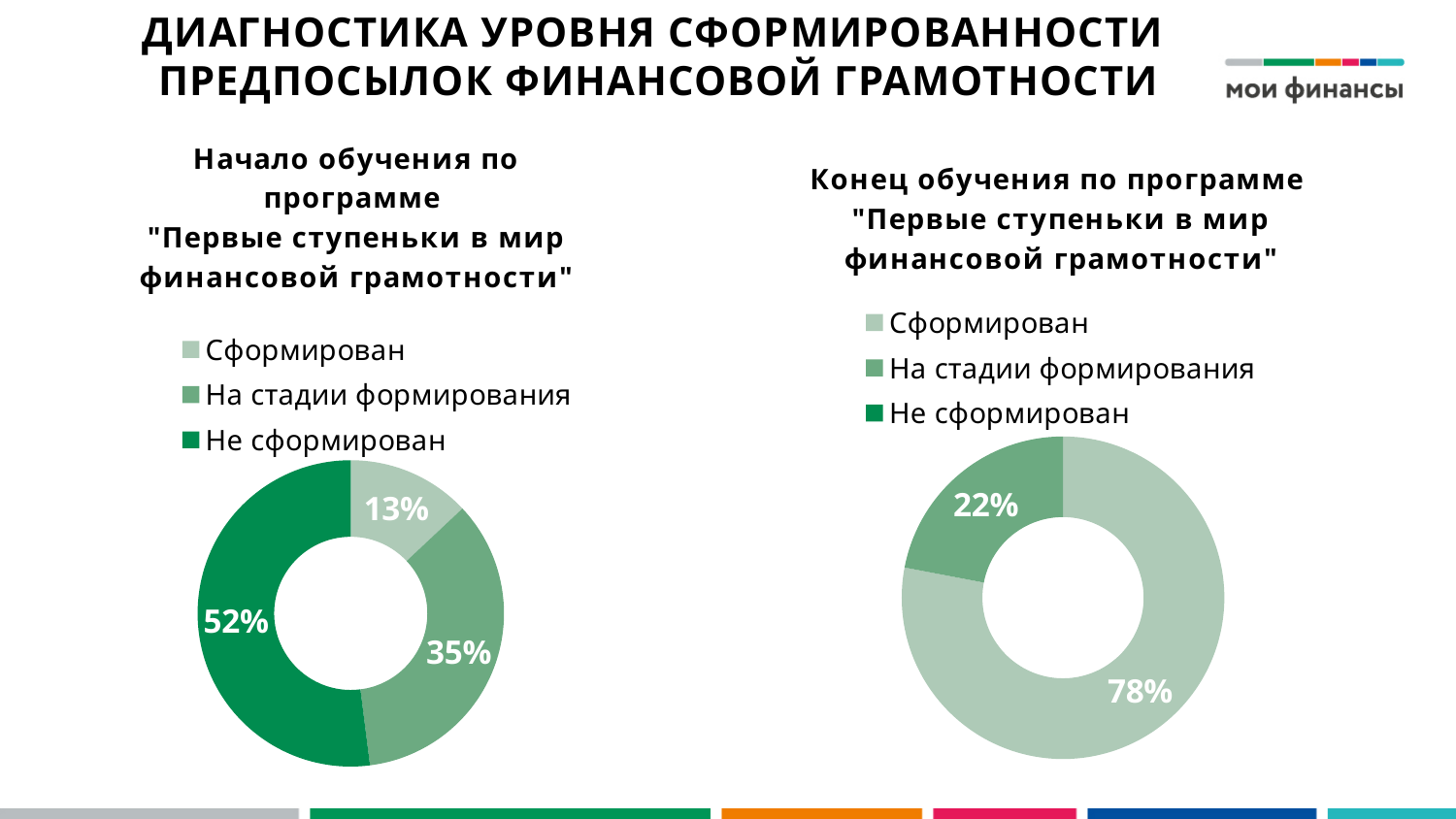
On the right chart ("Конец обучения по программе"), what is the difference between "Сформирован" and "На стадии формирования"? 56% On the left chart ("Начало обучения по программе"), what is the value for "Не сформирован"? 52% On the left chart ("Начало обучения по программе"), which category has the smallest share? Сформирован On the right chart ("Конец обучения по программе"), what is the value for "Сформирован"? 78% On the right chart ("Конец обучения по программе"), which labelled category has the largest share? Сформирован On the right chart ("Конец обучения по программе"), what is the value for "На стадии формирования"? 22% On the left chart ("Начало обучения по программе"), what is the difference between "Не сформирован" and "Сформирован"? 39% On the left chart ("Начало обучения по программе"), what is the value for "Сформирован"? 13% What kind of chart is used on the left side of the slide? Doughnut (pie) chart How many entries does the legend of the right chart ("Конец обучения по программе") list? 3 On the left chart ("Начало обучения по программе"), what is the value for "На стадии формирования"? 35% On the left chart ("Начало обучения по программе"), which category has the largest share? Не сформирован